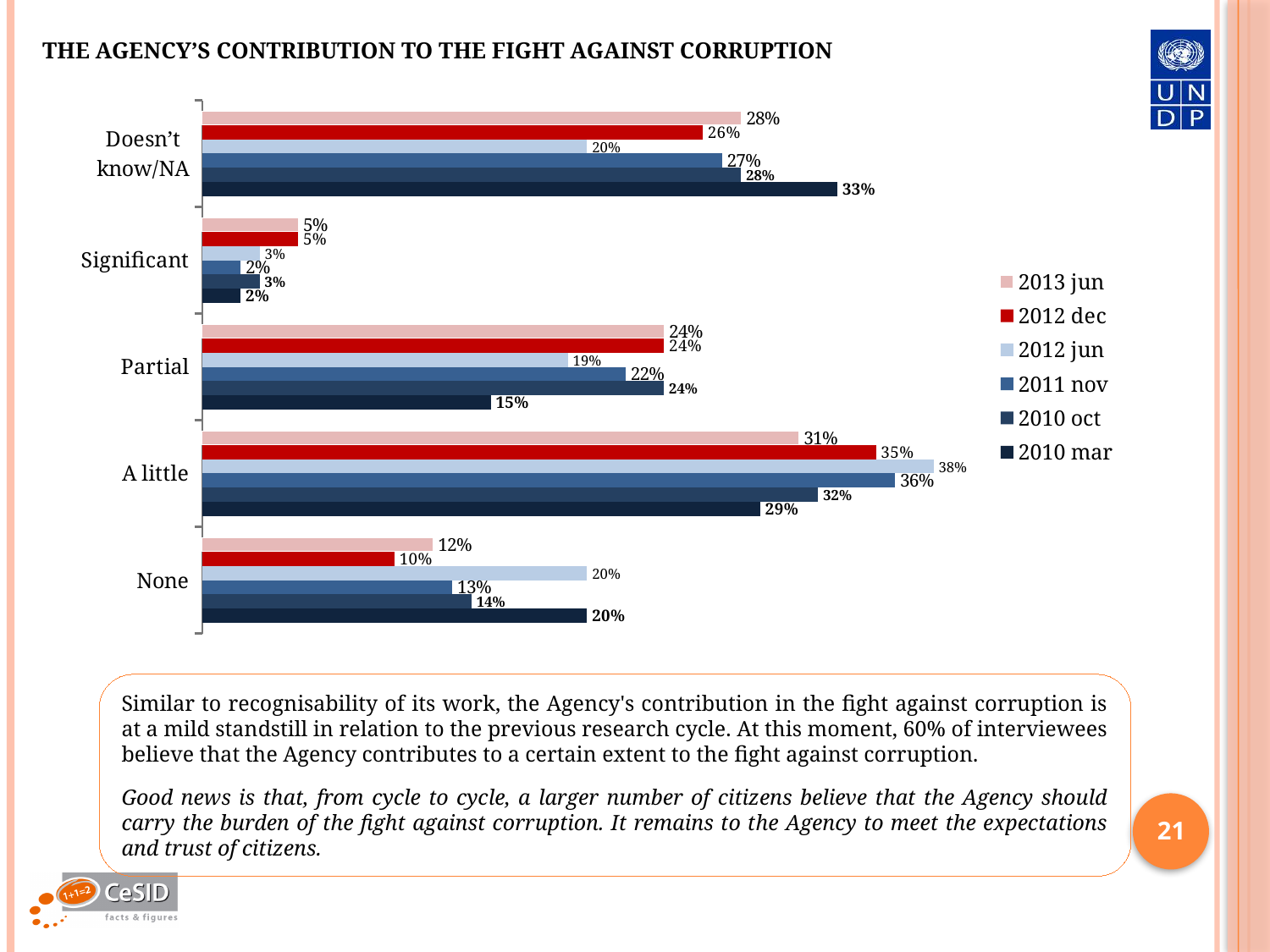
Which category has the highest value in the 2013 jun series? A little What is the title of the chart? THE AGENCY'S CONTRIBUTION TO THE FIGHT AGAINST CORRUPTION What is the value for 'A little' in the 2012 jun series? 38% What kind of chart is shown on the slide? bar chart Which is larger for 'Partial': the 2011 nov value or the 2010 mar value? 2011 nov How many categories are shown on the vertical axis? 5 What is the difference between the 2012 jun and 2013 jun values for 'None'? 8% What is the difference between the 2010 mar and 2012 jun values for 'Doesn't know/NA'? 13% What is the value for 'None' in the 2012 dec series? 10% How many series does the legend list? 6 What is the value for 'Doesn't know/NA' in the 2010 mar series? 33% Which category has the lowest value in the 2011 nov series? Significant